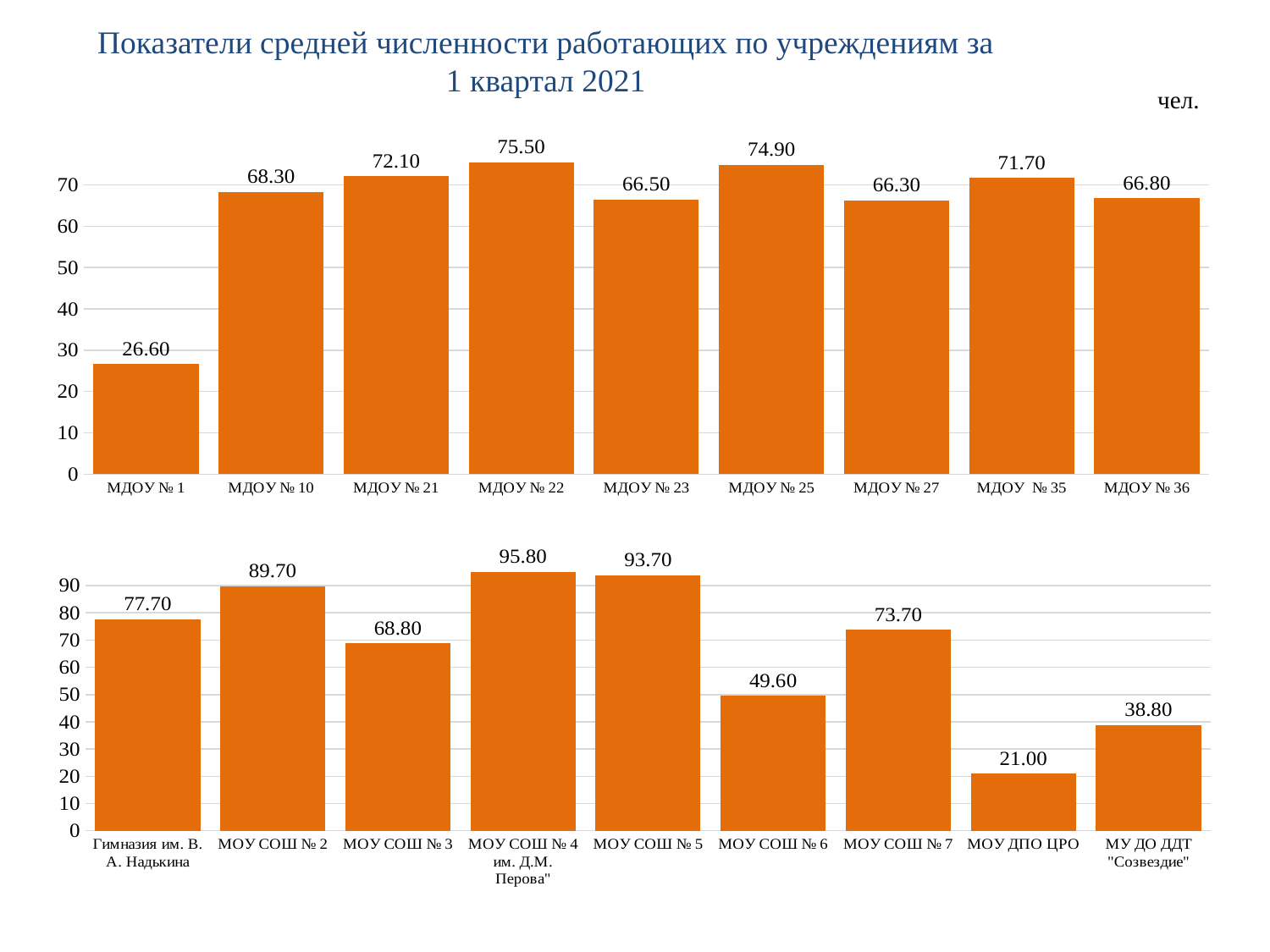
How many categories are shown in the top chart? 9 In the top chart, what is the value for МДОУ № 22? 75.50 In the bottom chart, which category has the highest value? МОУ СОШ № 4 им. Д.М. Перова In the bottom chart, is the value for МУ ДО ДДТ "Созвездие" greater or less than 40? less In the bottom chart, which category has the lowest value? МОУ ДПО ЦРО In the top chart, which is larger: the value for МДОУ № 21 or МДОУ № 23? МДОУ № 21 In the top chart, what is the difference between the values for МДОУ № 22 and МДОУ № 1? 48.90 What kind of chart is the bottom chart? bar chart In the bottom chart, what is the difference between the values for МОУ СОШ № 2 and МОУ СОШ № 3? 20.90 In the top chart, which category has the lowest value? МДОУ № 1 What unit is indicated at the top right of the slide for the charts? чел. In the bottom chart, what is the value for МОУ СОШ № 6? 49.60